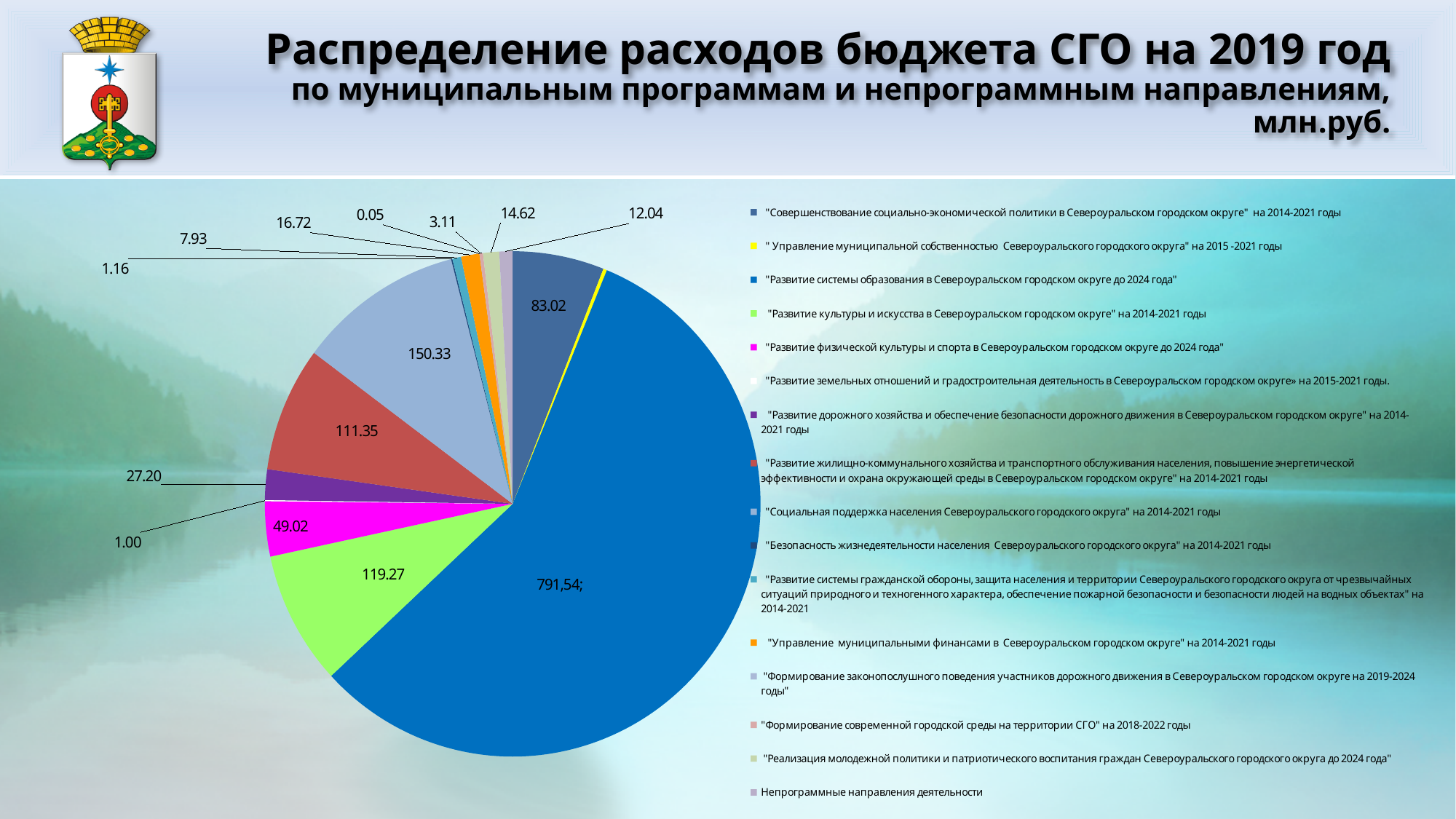
What kind of chart is shown on the slide? pie chart How many entries does the legend of the pie chart list? 16 What is the value for "Социальная поддержка населения Североуральского городского округа"? 150.33 Which is larger: the value for "Социальная поддержка населения" or for "Развитие жилищно-коммунального хозяйства..."? Социальная поддержка населения What is the value for "Развитие культуры и искусства в Североуральском городском округе"? 119.27 What is the value for "Развитие жилищно-коммунального хозяйства и транспортного обслуживания населения..."? 111.35 What is the value for "Развитие физической культуры и спорта в Североуральском городском округе до 2024 года"? 49.02 Which programme has the largest slice of the pie? "Развитие системы образования в Североуральском городском округе до 2024 года" What is the smallest value labelled on the pie chart? 0.05 What value is labelled on the largest slice of the pie? 791,54 What is the difference between the values for "Социальная поддержка населения" (150.33) and "Развитие жилищно-коммунального хозяйства..." (111.35)? 38.98 What is the value for "Развитие дорожного хозяйства и обеспечение безопасности дорожного движения..."? 27.20